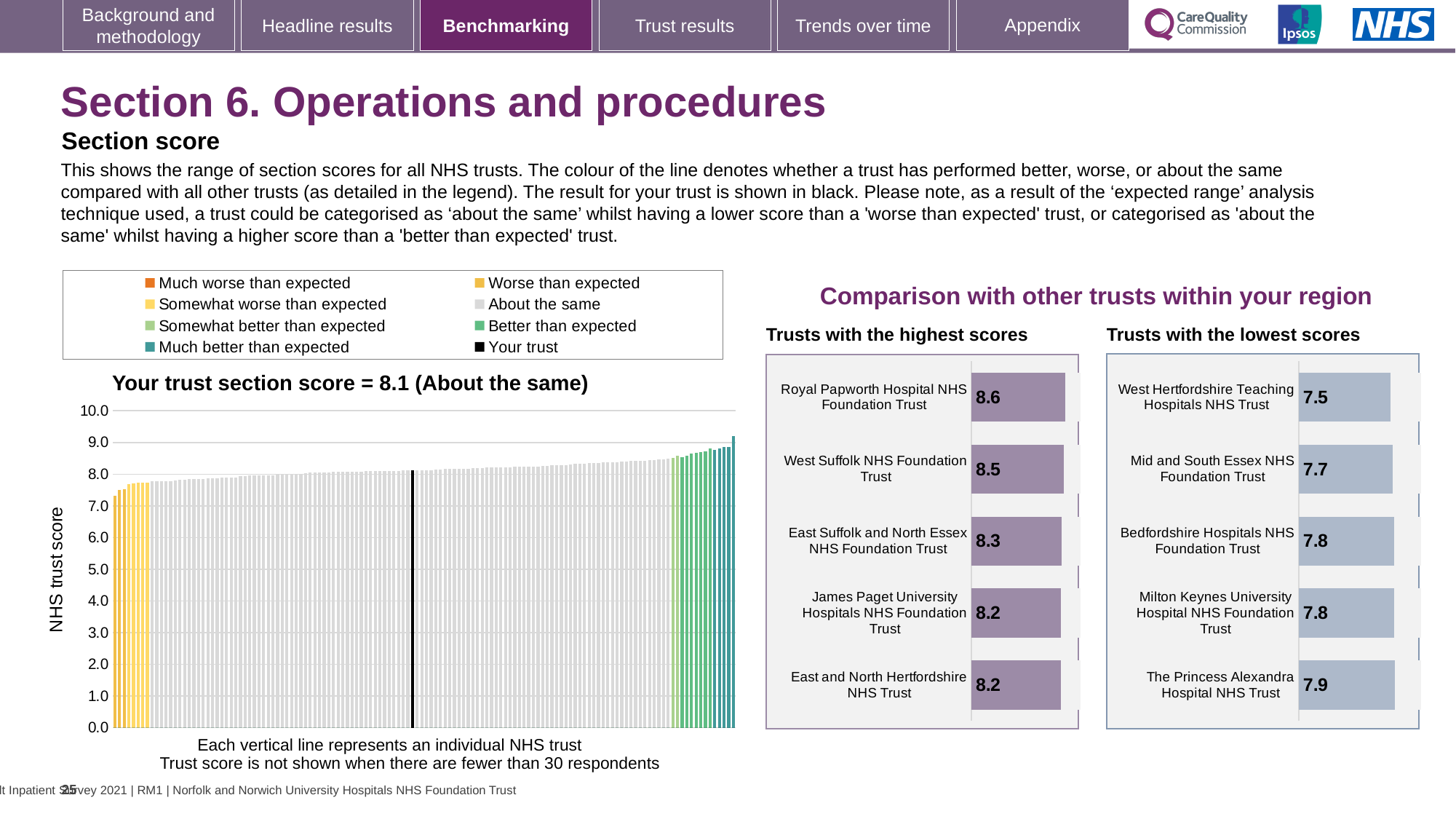
In the 'Trusts with the highest scores' chart, what is the difference between the scores of Royal Papworth Hospital NHS Foundation Trust and East and North Hertfordshire NHS Trust? 0.4 How many entries does the legend above the 'Your trust section score' chart list? 8 In the 'Your trust section score' chart, do the bar values rise or fall from left to right? Rise In the 'Your trust section score' chart, what is the section score for your trust? 8.1 In the 'Trusts with the highest scores' chart, which trust has the highest score? Royal Papworth Hospital NHS Foundation Trust In the 'Trusts with the lowest scores' chart, which has the larger score: Mid and South Essex NHS Foundation Trust or The Princess Alexandra Hospital NHS Trust? The Princess Alexandra Hospital NHS Trust In the 'Trusts with the lowest scores' chart, what is the score for Mid and South Essex NHS Foundation Trust? 7.7 In the 'Trusts with the highest scores' chart, what is the score for Royal Papworth Hospital NHS Foundation Trust? 8.6 What kind of chart is the 'Your trust section score' chart on the left of the slide? Bar chart In the 'Trusts with the lowest scores' chart, which trust has the lowest score? West Hertfordshire Teaching Hospitals NHS Trust In the 'Trusts with the highest scores' chart, how many trusts are shown? 5 In the 'Trusts with the lowest scores' chart, what is the difference between the scores of The Princess Alexandra Hospital NHS Trust and West Hertfordshire Teaching Hospitals NHS Trust? 0.4